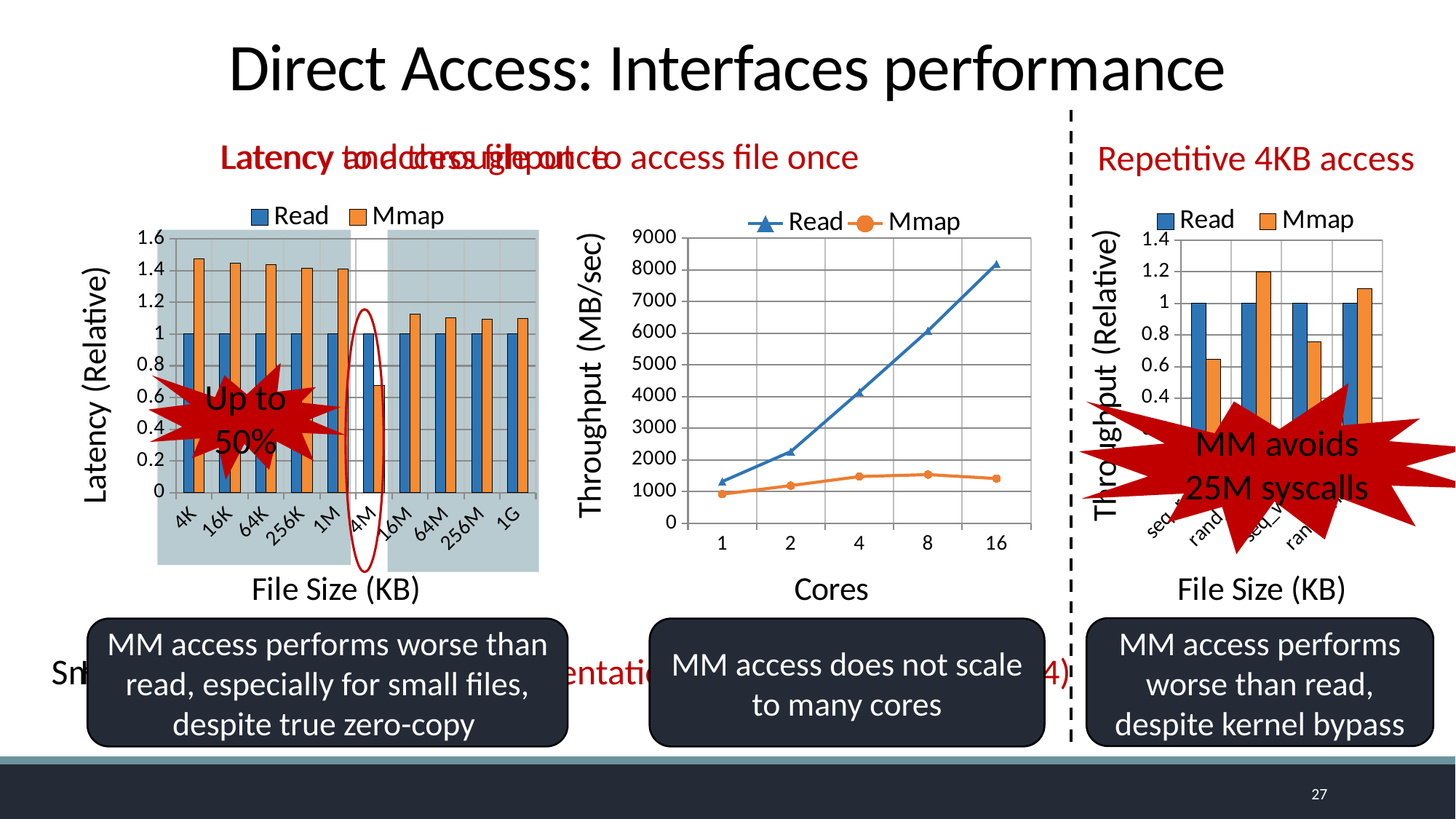
On the middle chart (Throughput vs Cores), is the Read value at 16 cores greater or less than 8000? greater On the left chart (Latency), at 4M, which is larger, Read or Mmap? Read On the left chart (Latency), is the Mmap value for 4K greater or less than 1.4? greater On the left chart (Latency), what is the Read value for 4K? 1 On the left chart (Latency), how many file size categories are shown on the x axis? 10 On the middle chart (Throughput vs Cores), how many series does the legend list? 2 On the left chart (Latency), what kind of chart is it? bar chart On the middle chart (Throughput vs Cores), does the Read series rise or fall as the number of cores increases? rise On the left chart (Latency), which file size has the lowest Mmap value? 4M On the right chart (Repetitive 4KB access), what is the label of the y axis? Throughput (Relative) On the middle chart (Throughput vs Cores), is the Mmap value at 16 cores greater or less than 2000? less On the middle chart (Throughput vs Cores), what kind of chart is it? line chart